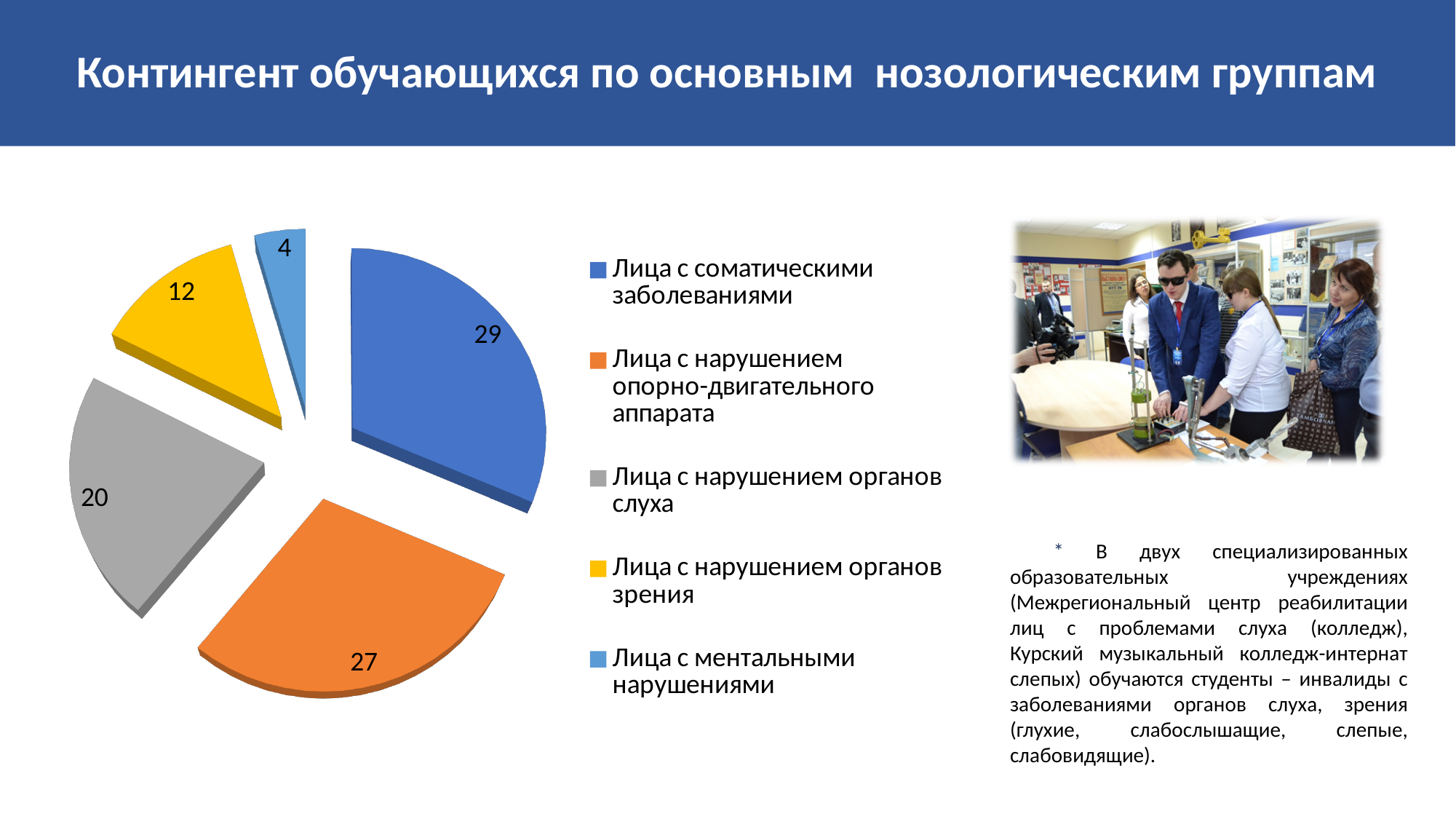
What kind of chart is shown on the slide? Pie chart Which category has the largest slice of the pie? Лица с соматическими заболеваниями What is the value for "Лица с нарушением органов зрения"? 12 Which is larger: the value for "Лица с нарушением опорно-двигательного аппарата" or for "Лица с нарушением органов слуха"? Лица с нарушением опорно-двигательного аппарата What is the difference between the values for "Лица с нарушением органов слуха" and "Лица с нарушением органов зрения"? 8 Which category has the smallest slice of the pie? Лица с ментальными нарушениями What is the value for "Лица с ментальными нарушениями"? 4 What is the value for "Лица с нарушением опорно-двигательного аппарата"? 27 What is the value for "Лица с нарушением органов слуха"? 20 What colour is the slice for "Лица с нарушением органов зрения"? Yellow How many categories does the pie chart have? 5 What is the value for "Лица с соматическими заболеваниями"? 29